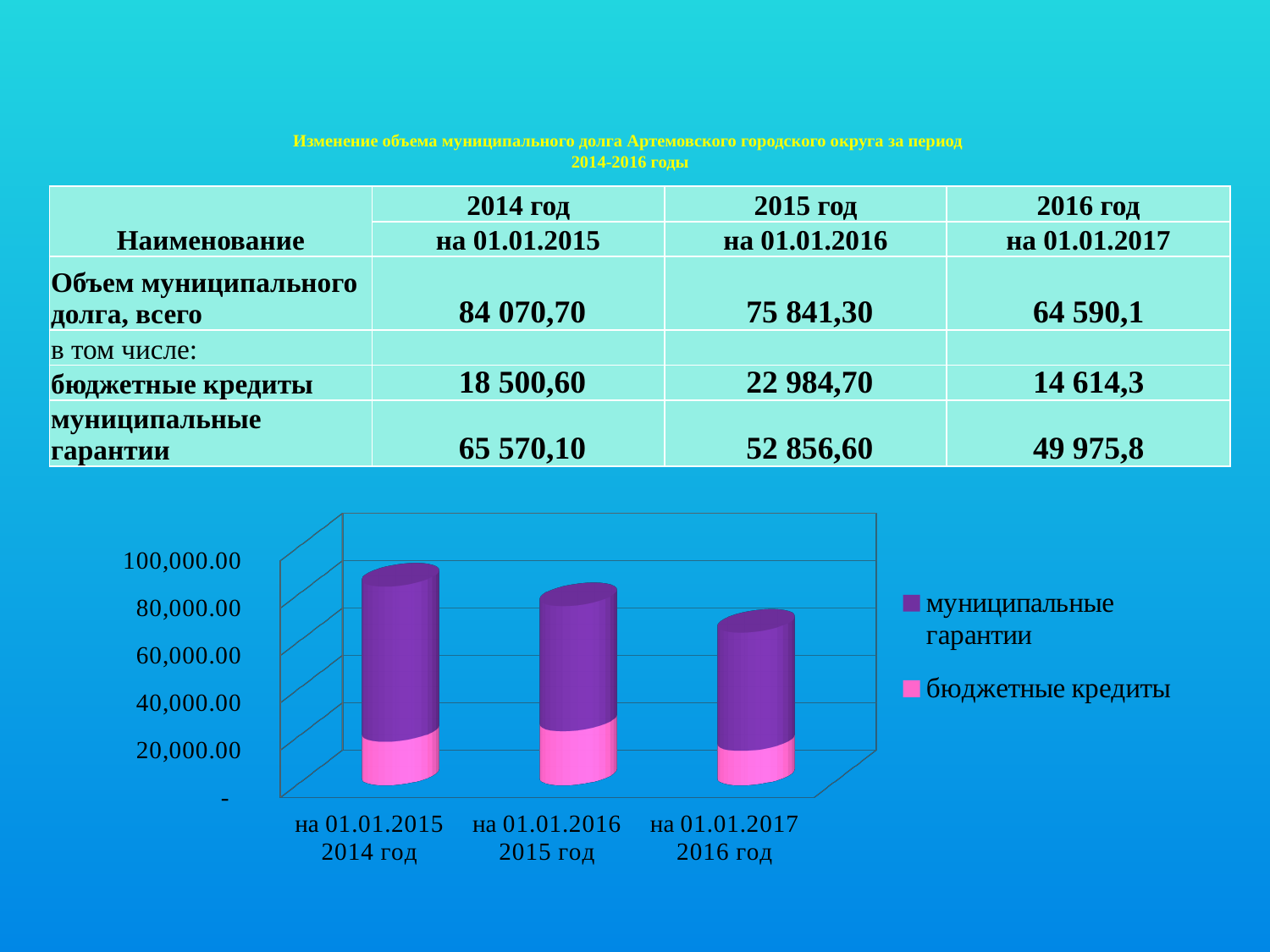
Is the total stacked bar for на 01.01.2016 greater or less than 60,000.00? greater What is the total height of the stacked bar for на 01.01.2017 (2016 год)? 64 590,1 Which series is shown in purple in the chart? муниципальные гарантии What kind of chart is shown on the slide? bar chart How many series does the chart legend list? 2 How many bars (dates) are plotted on the chart? 3 According to the slide, what is the value of бюджетные кредиты на 01.01.2016? 22 984,70 Which series is shown in pink in the chart? бюджетные кредиты According to the slide, what is the value of муниципальные гарантии на 01.01.2015? 65 570,10 Which date has the shortest stacked bar in the chart? на 01.01.2017 (2016 год) Which date has the tallest stacked bar in the chart? на 01.01.2015 (2014 год) Do the total stacked bar heights rise or fall from 2014 год to 2016 год? fall